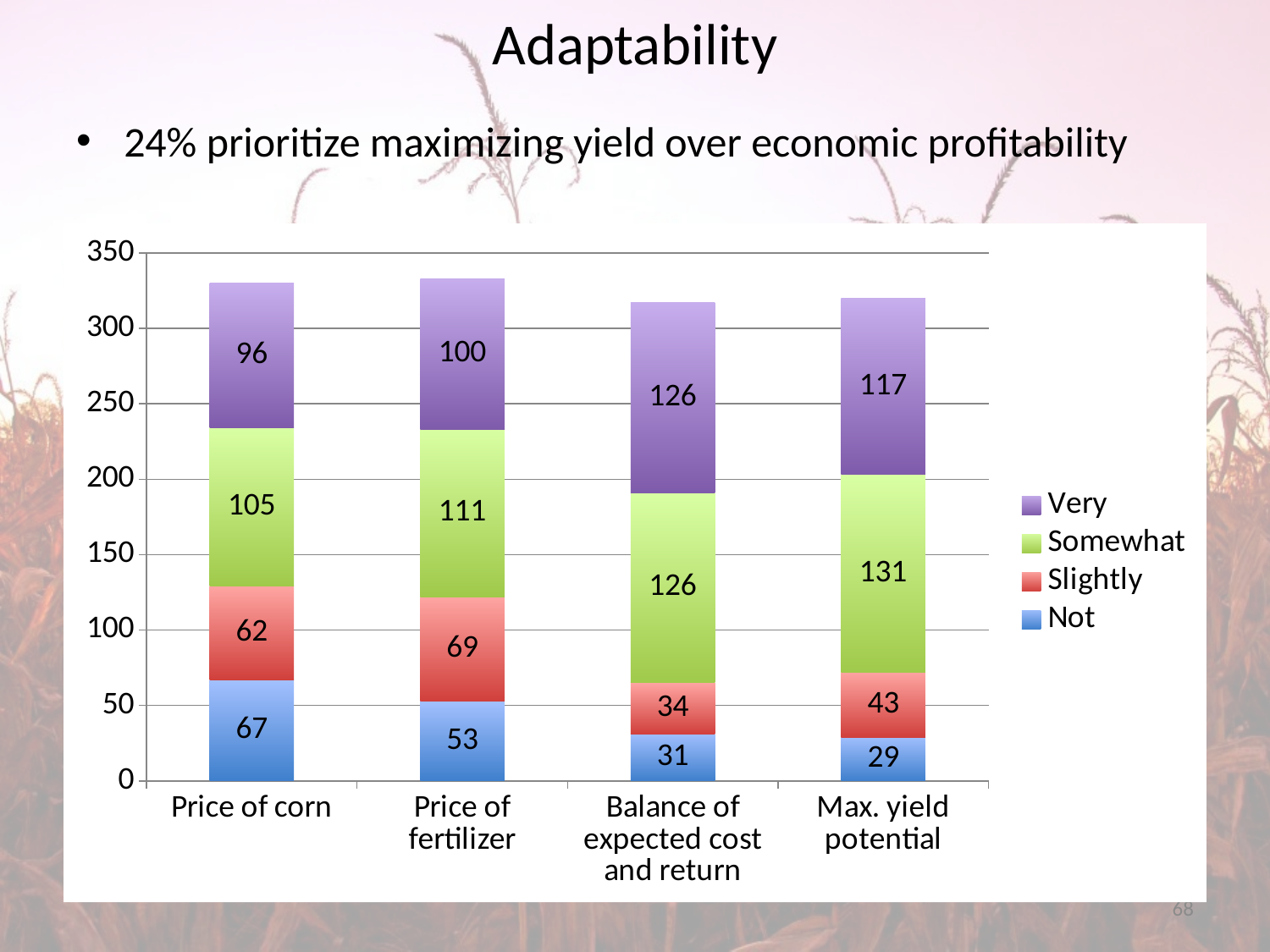
How many series does the legend list? 4 What is the total of the stacked bar for 'Price of corn'? 330 What is the 'Very' value for 'Max. yield potential'? 117 What kind of chart is shown on the slide? Stacked bar chart What is the difference between the 'Very' values for 'Balance of expected cost and return' and 'Price of corn'? 30 Which legend entry is shown in purple? Very What is the 'Slightly' value for 'Balance of expected cost and return'? 34 Which category has the lowest 'Not' value? Max. yield potential Which is larger, the 'Slightly' value for 'Price of corn' or for 'Price of fertilizer'? Price of fertilizer How many categories are shown on the x axis? 4 Which category has the highest 'Somewhat' value? Max. yield potential What is the 'Not' value for 'Price of fertilizer'? 53